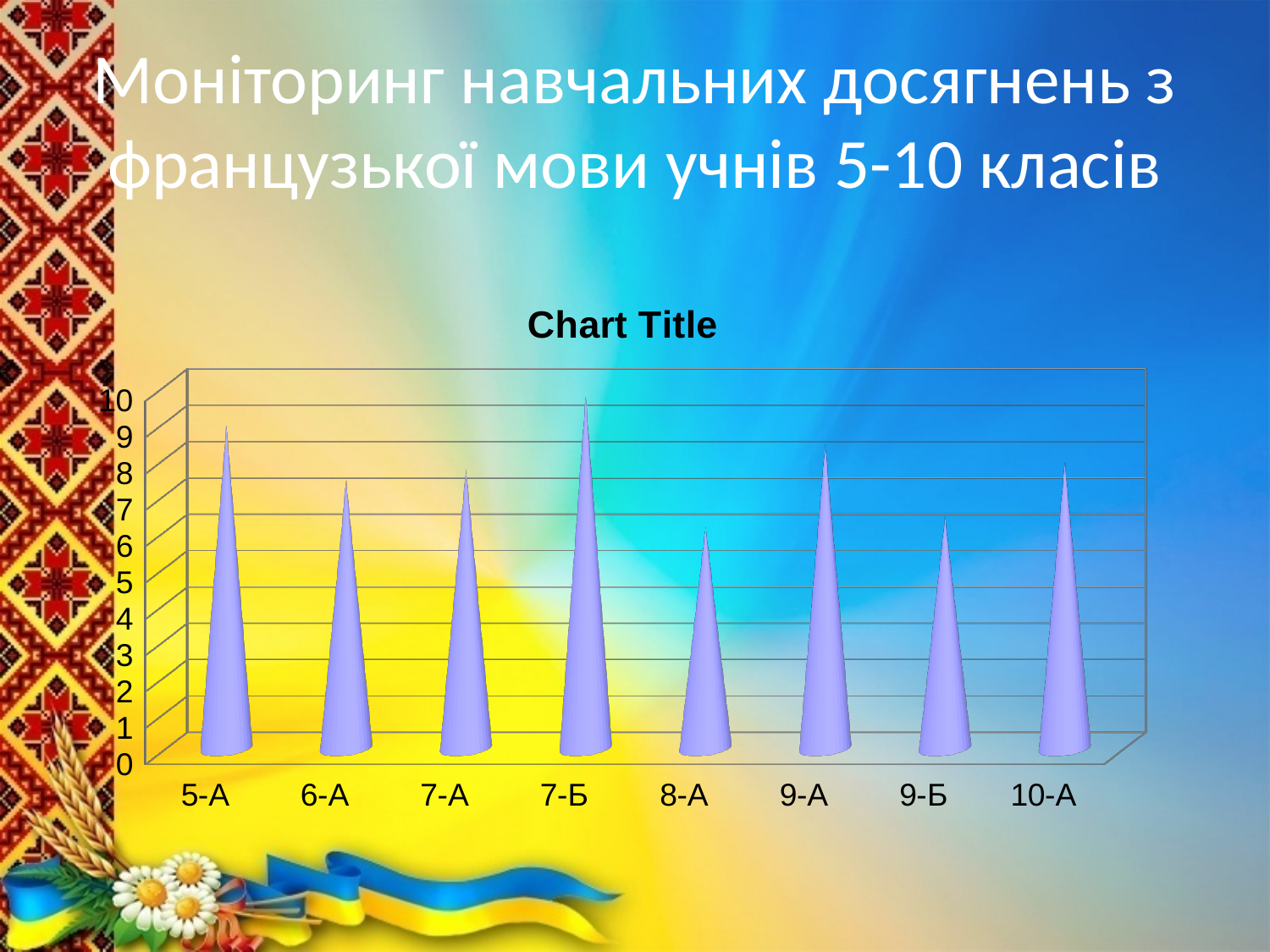
Which has the larger value, 9-А or 9-Б? 9-А How many classes (categories) are shown on the x axis of the chart? 8 Is the value for 5-А greater or less than 7? greater What is the highest value shown on the chart's vertical axis? 10 Is the value for 7-Б greater or less than 8? greater Is the value for 9-Б greater or less than 8? less What type of chart is shown on the slide? bar chart What is the title printed above the chart? Chart Title Which has the larger value, 5-А or 6-А? 5-А Which class has the highest value in the chart? 7-Б